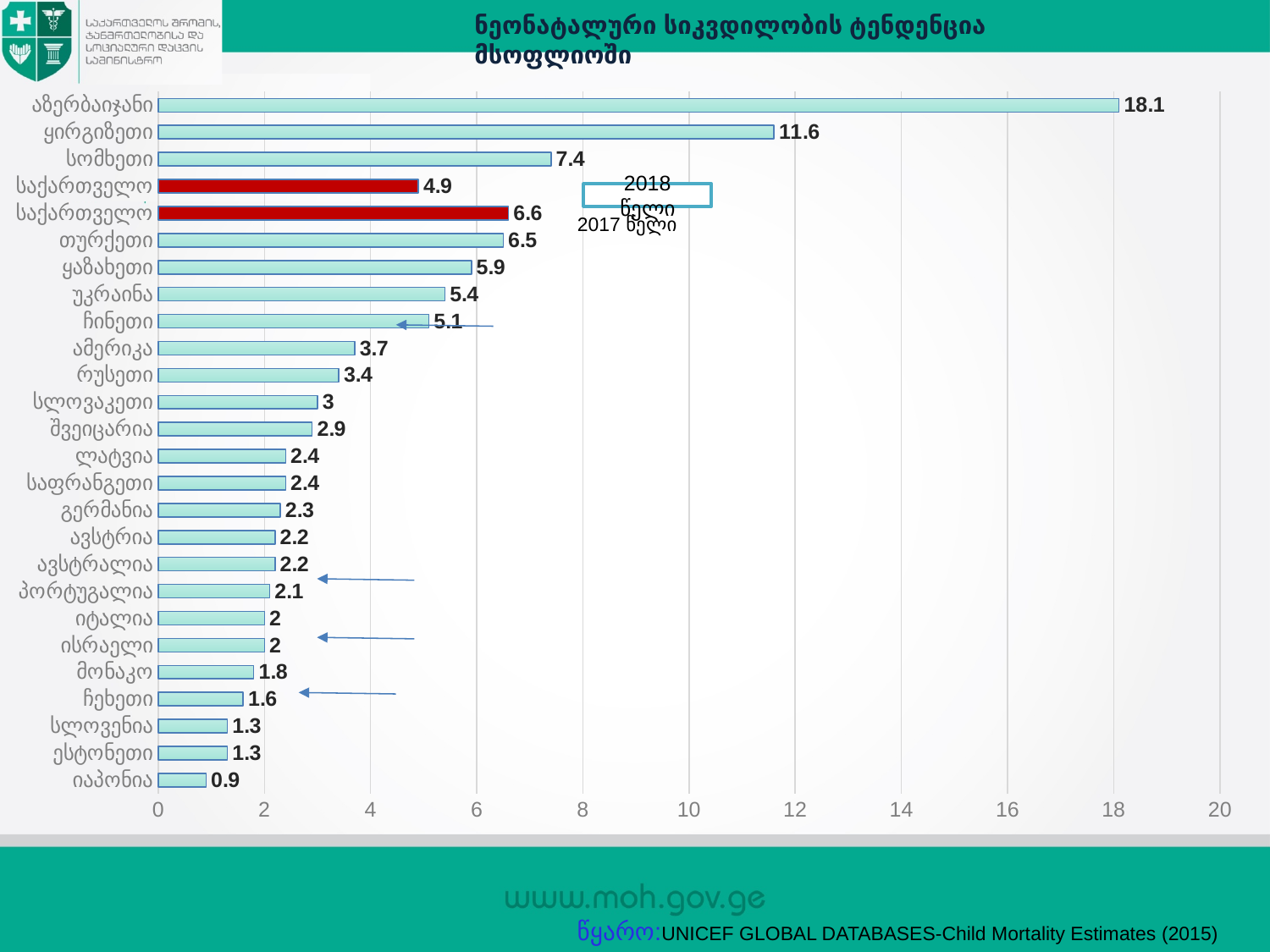
What is the value for აზერბაიჯანი? 18.1 What is the value for the საქართველო bar labelled 2018 წელი? 4.9 What is the difference between the საქართველო 2017 value and the საქართველო 2018 value? 1.7 What type of chart is shown on the slide? bar chart Which has a larger value, თურქეთი or ყაზახეთი? თურქეთი Which bars are coloured red on the chart? the two საქართველო bars What is the difference between the value for აზერბაიჯანი and the value for ყირგიზეთი? 6.5 What is the value for ყირგიზეთი? 11.6 Which category has the highest value? აზერბაიჯანი What is the value for the საქართველო bar labelled 2017 წელი? 6.6 How many bars are plotted on the chart? 26 Which category has the lowest value? იაპონია